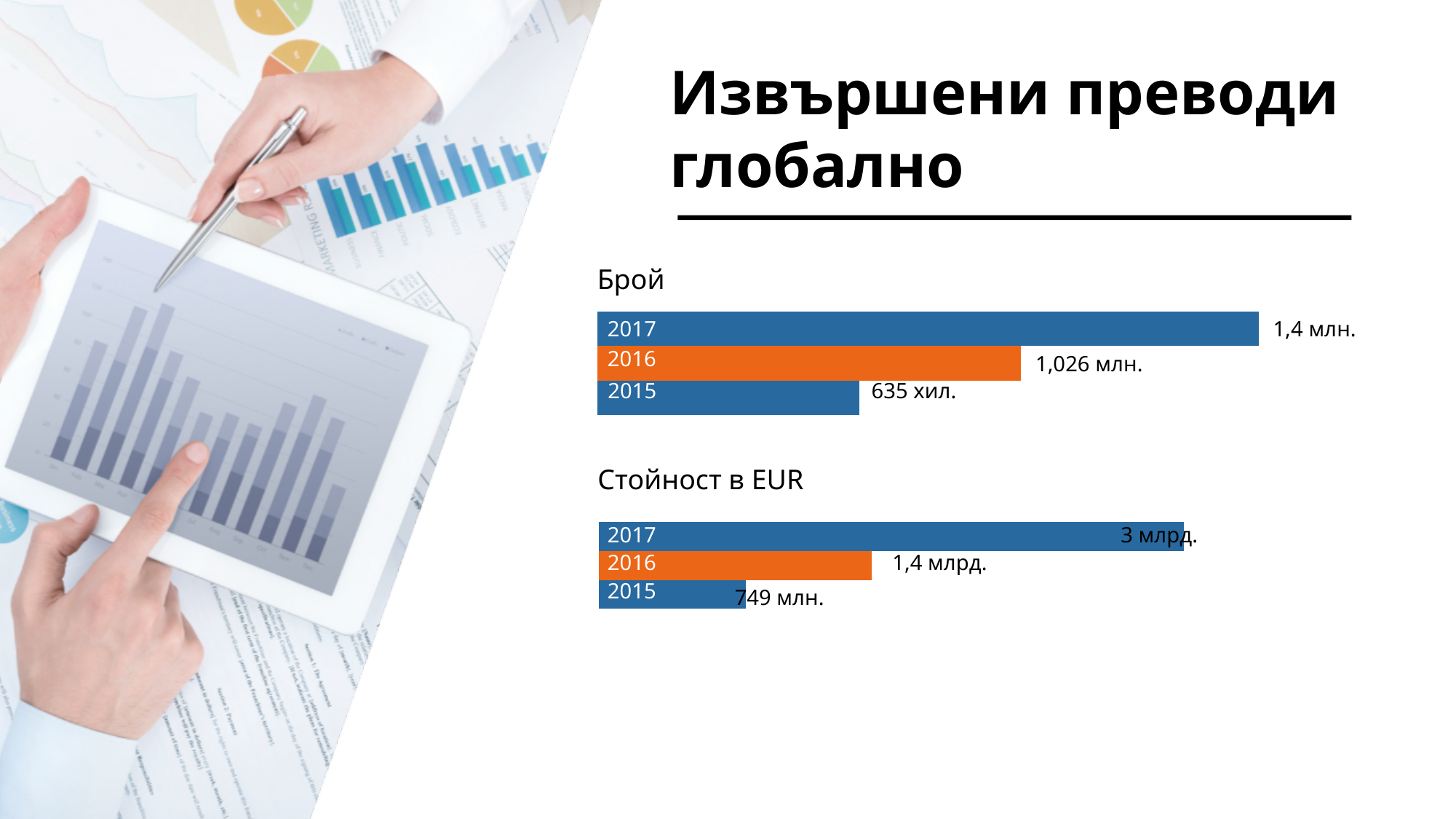
What kind of chart is the "Брой" chart? Bar chart In the "Брой" chart, which is larger: the value for 2016 or the value for 2015? 2016 How many bars does the "Стойност в EUR" chart show? 3 In the "Стойност в EUR" chart, what is the value for 2017? 3 млрд. In the "Брой" chart, which year has the highest value? 2017 In the "Стойност в EUR" chart, what is the difference between the 2017 and 2016 values? 1,6 млрд. In the "Стойност в EUR" chart, which year has the lowest value? 2015 In the "Стойност в EUR" chart, what is the value for 2016? 1,4 млрд. In the "Брой" chart, what is the value for 2017? 1,4 млн. In the "Брой" chart, what is the value for 2016? 1,026 млн. In the "Брой" chart, what is the value for 2015? 635 хил. In the "Стойност в EUR" chart, what is the value for 2015? 749 млн.